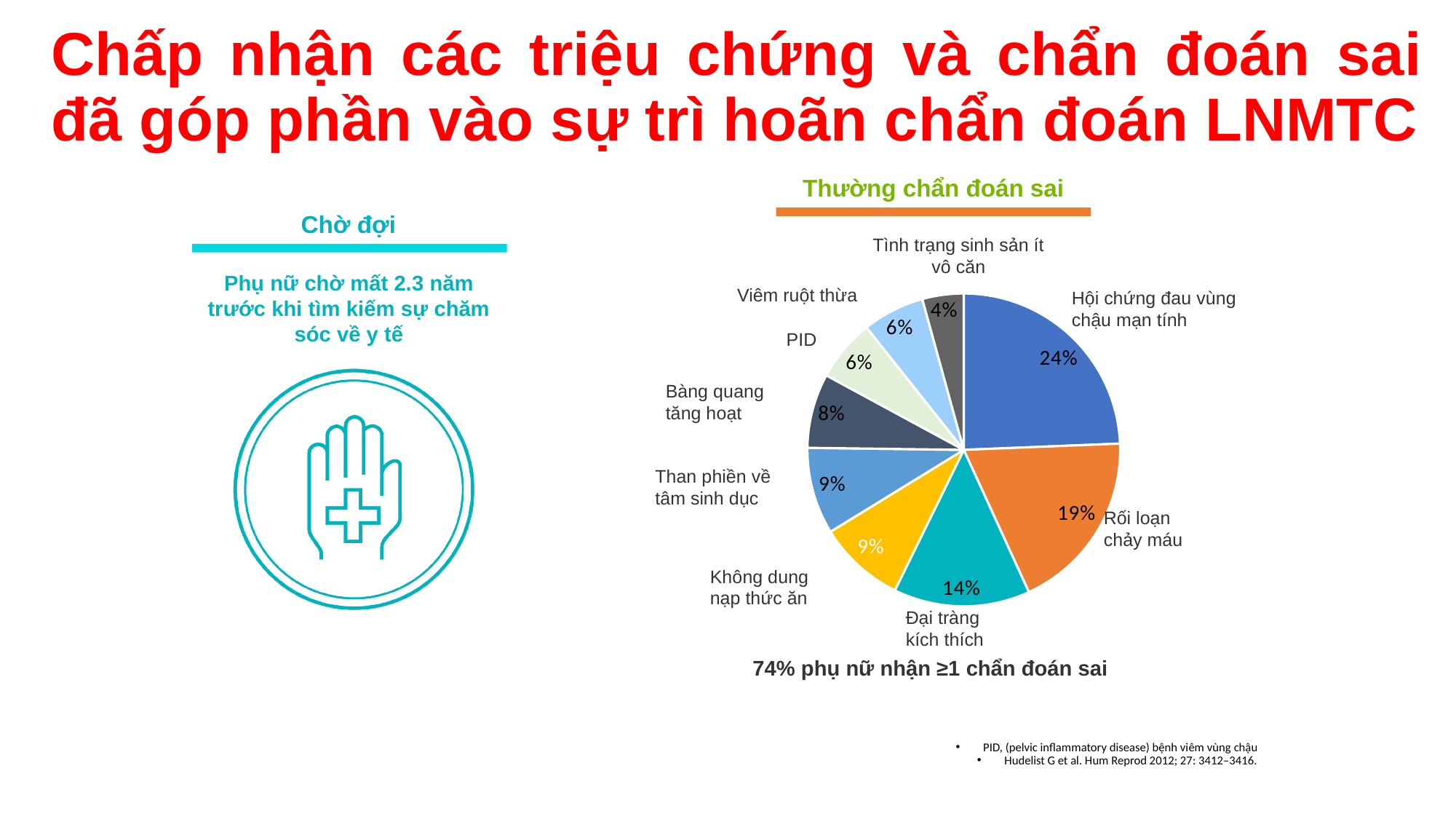
What is the value for "Bàng quang tăng hoạt"? 8% What share of the pie is labelled "Hội chứng đau vùng chậu mạn tính"? 24% Which category has the largest slice of the pie? Hội chứng đau vùng chậu mạn tính What is the value for "Rối loạn chảy máu"? 19% Which is larger, the value for "Đại tràng kích thích" or the value for "Bàng quang tăng hoạt"? Đại tràng kích thích What is the value for "Tình trạng sinh sản ít vô căn"? 4% What is the value for "Đại tràng kích thích"? 14% What is the difference between the values for "Hội chứng đau vùng chậu mạn tính" and "Rối loạn chảy máu"? 5% Which category has the smallest slice of the pie? Tình trạng sinh sản ít vô căn How many slices does the pie chart have? 9 What is the title shown above the pie chart? Thường chẩn đoán sai What kind of chart is shown on the slide? pie chart